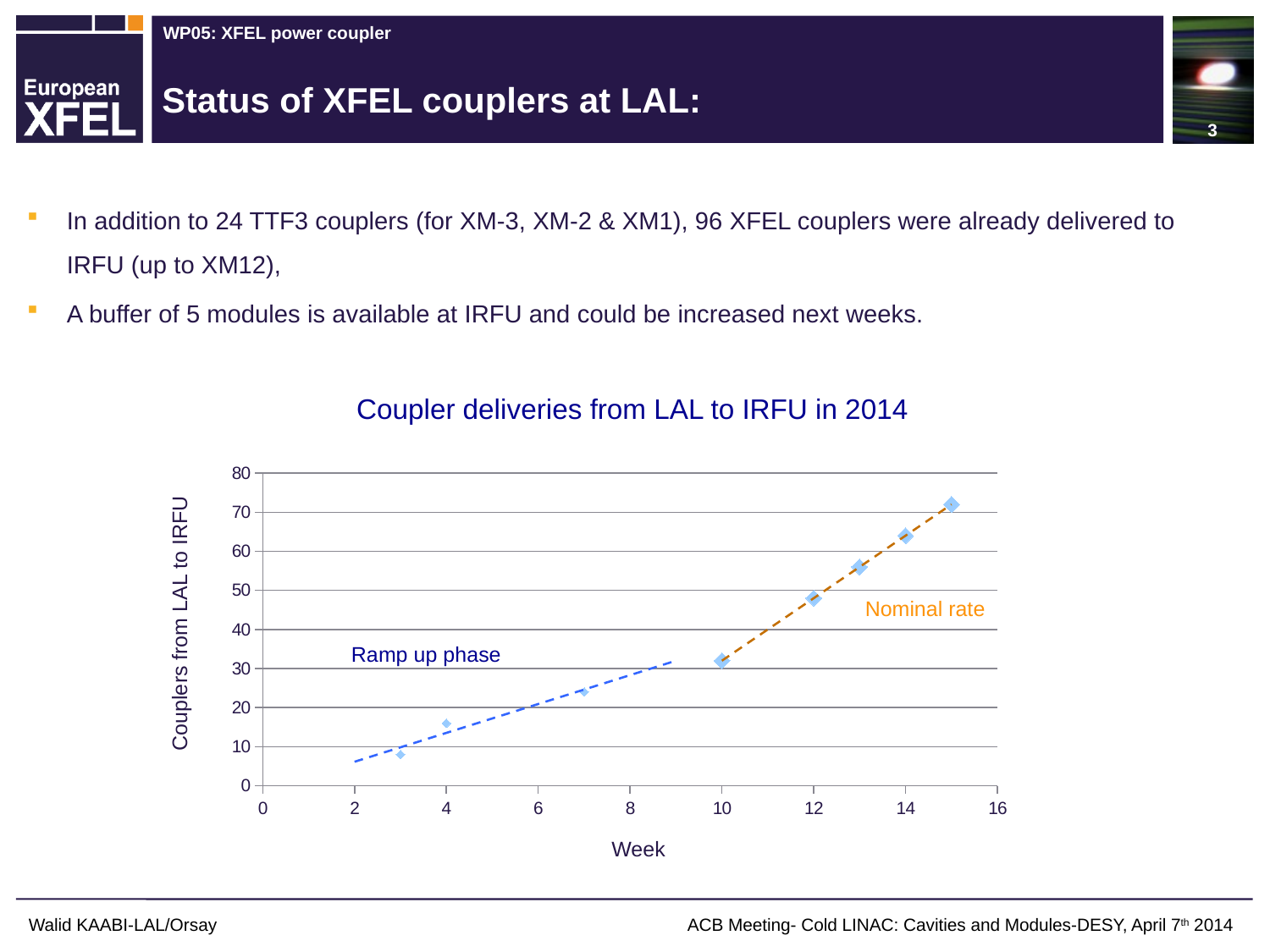
What is the label of the x axis of the chart? Week Is the value for week 4 greater or less than 20? less How many data points are plotted on the chart? 8 Is the value for week 13 greater or less than 50? greater At which week is the plotted value lowest? 3 At which week is the plotted value highest? 15 Which has the larger value, week 14 or week 10? week 14 Is the value for week 7 greater or less than 30? less What kind of chart is shown on the slide? scatter chart Do the plotted values rise or fall as the week number increases? rise What is the title of the chart? Coupler deliveries from LAL to IRFU in 2014